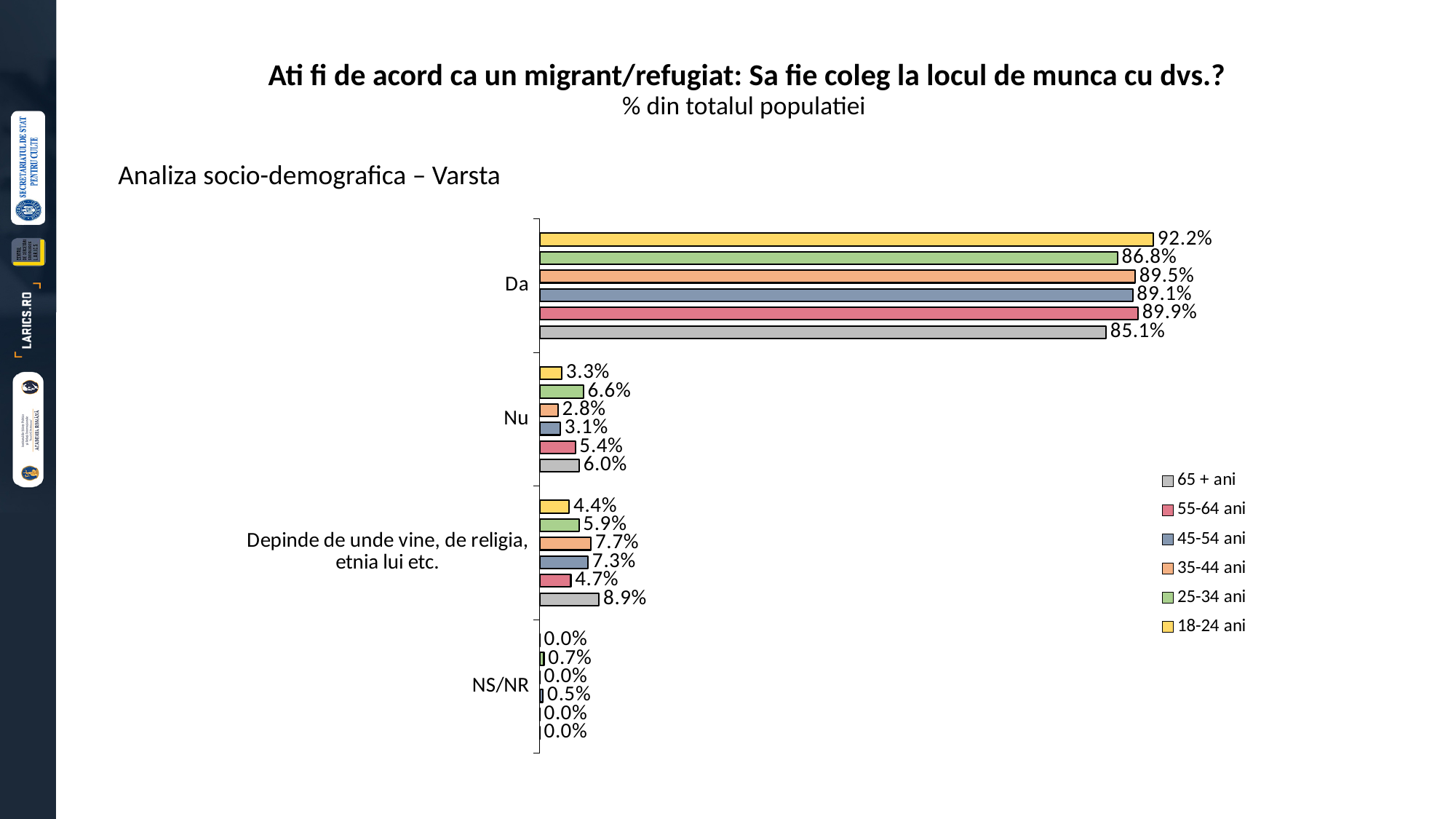
What type of chart is shown on the slide? Bar chart How many answer categories are shown on the chart? 4 In the "Nu" category, which is larger: the value for 25-34 ani or the value for 35-44 ani? 25-34 ani What is the value for the 65 + ani group in the "Nu" category? 6.0% How many age groups does the legend list? 6 Which age group has the highest value in the "Da" category? 18-24 ani What is the value for the 25-34 ani group in the "NS/NR" category? 0.7% Which age group has the lowest value in the "Da" category? 65 + ani What percentage of the 18-24 ani group answered "Da"? 92.2% What is the value for the 35-44 ani group in the "Depinde de unde vine, de religia, etnia lui etc." category? 7.7% What is the difference between the 18-24 ani and 65 + ani values in the "Da" category? 7.1% Which age group has the highest value in the "Depinde de unde vine, de religia, etnia lui etc." category? 65 + ani